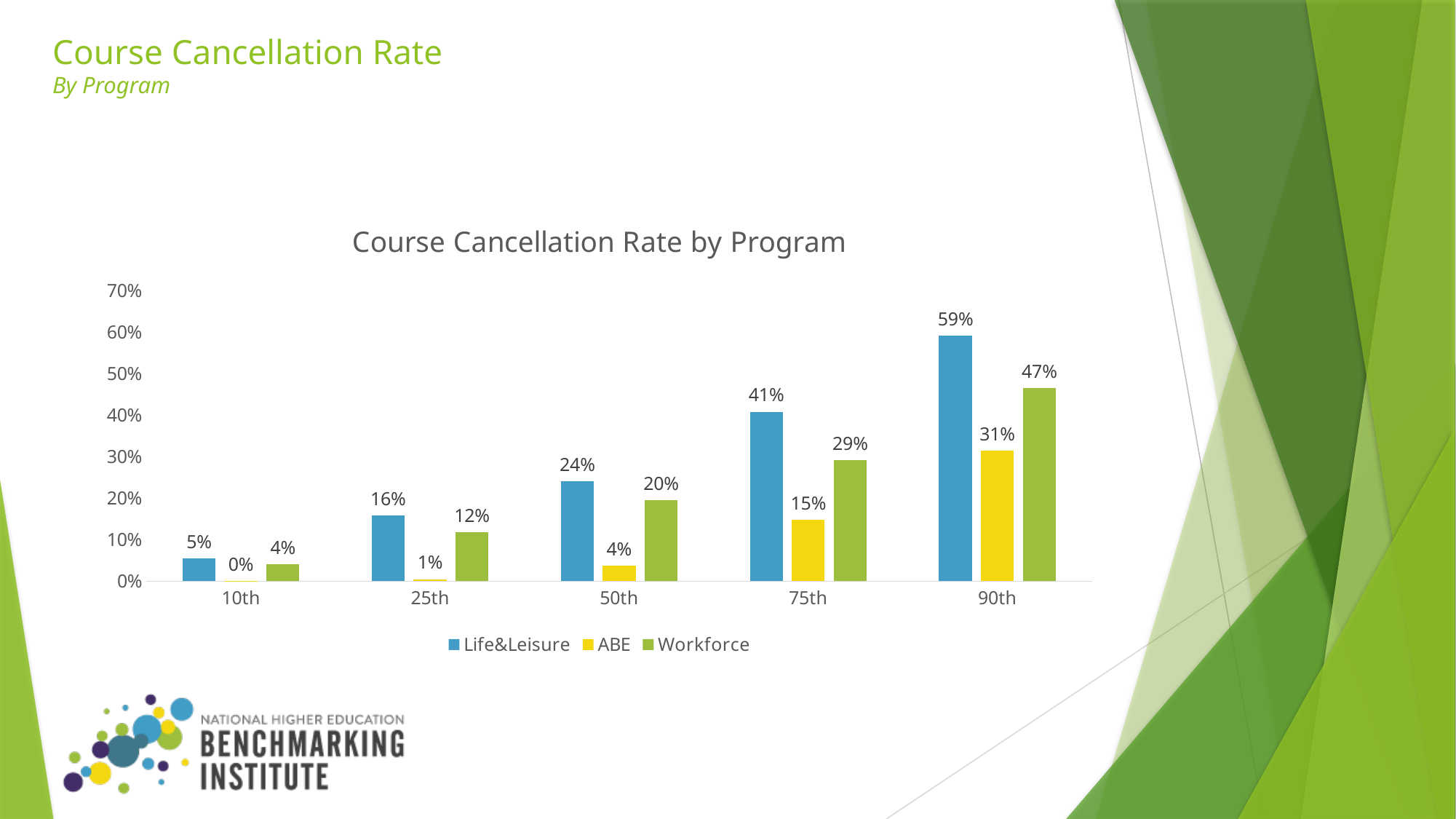
How many percentile categories are shown on the x axis? 5 What is the Life&Leisure course cancellation rate at the 90th percentile? 59% Do the Workforce values rise or fall from the 10th to the 90th percentile? Rise What kind of chart is shown on the slide? Bar chart What is the difference between the Life&Leisure and Workforce values at the 75th percentile? 12% At the 10th percentile, which is larger: the Life&Leisure value or the Workforce value? Life&Leisure How many series does the legend list? 3 Which series has the lowest value at the 25th percentile? ABE What is the ABE course cancellation rate at the 75th percentile? 15% What is the title of the chart? Course Cancellation Rate by Program Which series has the highest value at the 90th percentile? Life&Leisure What is the Workforce course cancellation rate at the 50th percentile? 20%